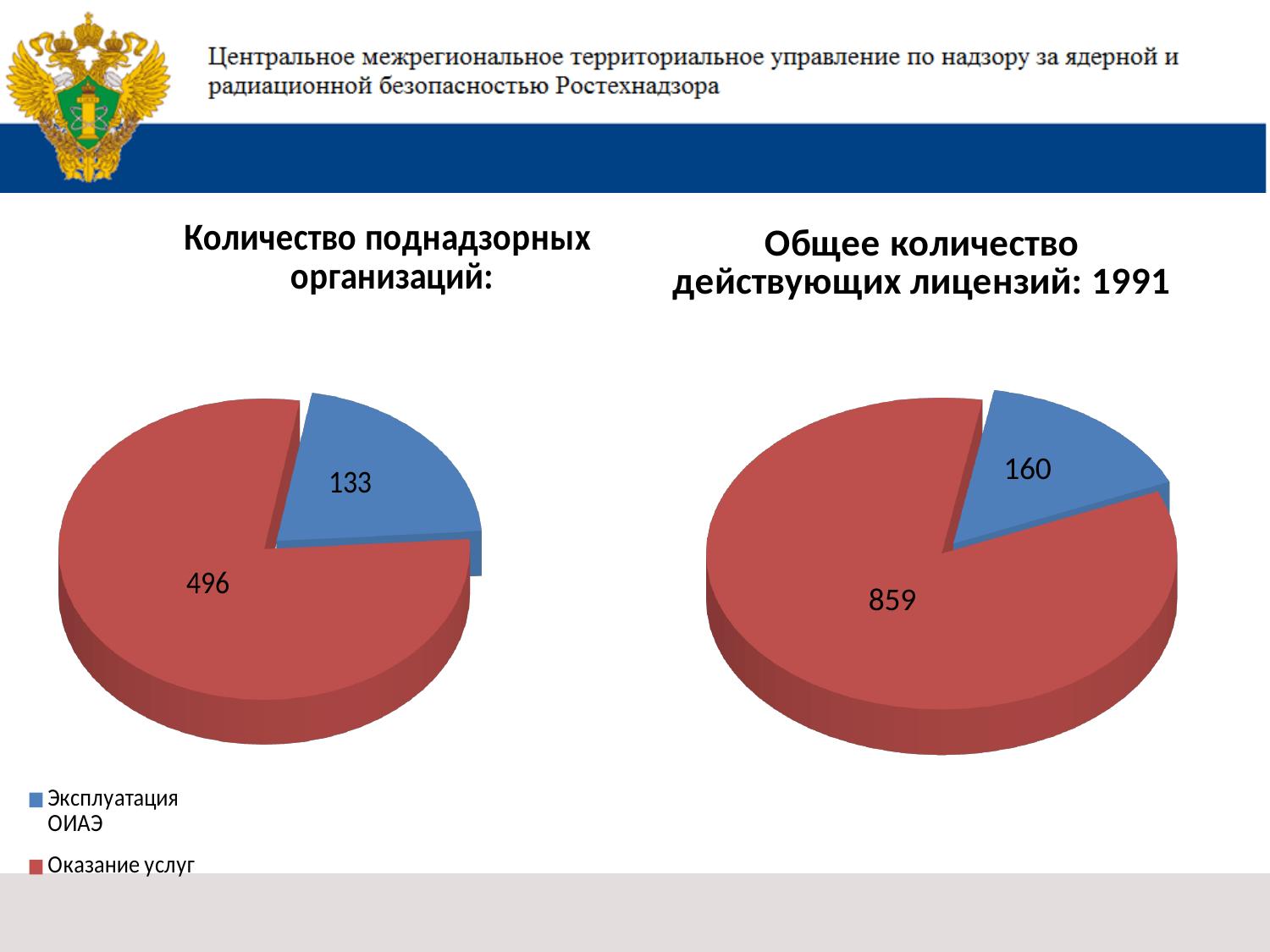
How many slices does the left chart 'Количество поднадзорных организаций' have? 2 In the right chart 'Общее количество действующих лицензий', which category has the smallest slice? Эксплуатация ОИАЭ In the right chart 'Общее количество действующих лицензий', what is the difference between Оказание услуг and Эксплуатация ОИАЭ? 699 Comparing the two charts, is the Эксплуатация ОИАЭ value larger in the left chart or the right chart? right chart In the left chart 'Количество поднадзорных организаций', what is the value for Эксплуатация ОИАЭ? 133 In the left chart 'Количество поднадзорных организаций', what is the value for Оказание услуг? 496 In the left chart 'Количество поднадзорных организаций', what is the difference between Оказание услуг and Эксплуатация ОИАЭ? 363 In the right chart 'Общее количество действующих лицензий', what is the value for Эксплуатация ОИАЭ? 160 In the right chart 'Общее количество действующих лицензий', what is the value for Оказание услуг? 859 What type of chart is used on this slide? pie chart Which colour represents Оказание услуг in the legend? red In the left chart 'Количество поднадзорных организаций', which category has the largest slice? Оказание услуг